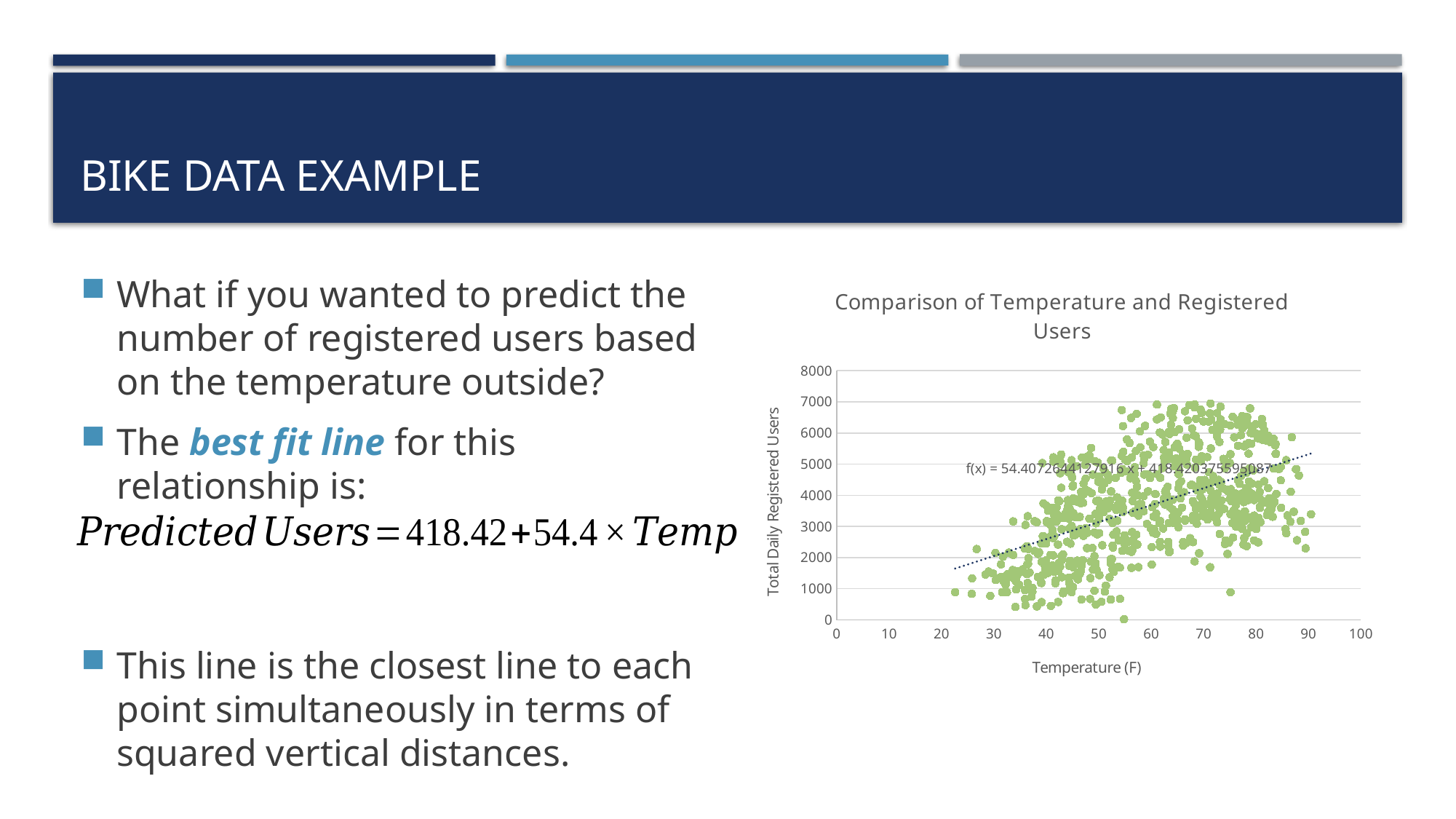
What is the title of the chart? Comparison of Temperature and Registered Users Does the dotted trendline on the chart slope upward or downward from left to right? upward What kind of chart is shown on the slide? scatter chart Do the registered user values generally rise or fall as temperature increases along the x axis? rise What is the label on the x axis of the chart? Temperature (F)